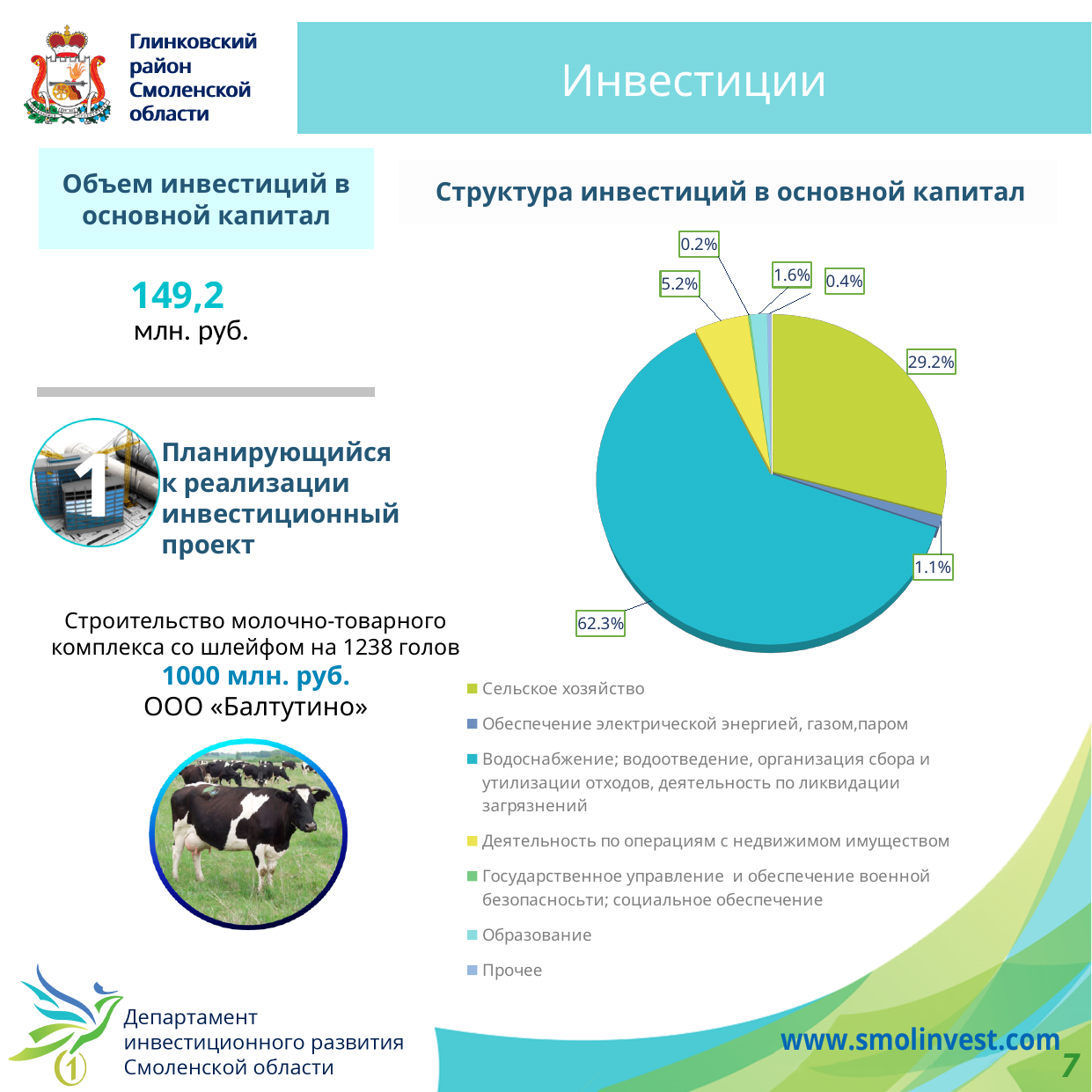
In the pie chart, what share is shown for "Водоснабжение; водоотведение, организация сбора и утилизации отходов, деятельность по ликвидации загрязнений"? 62.3% In the pie chart, what share is shown for "Обеспечение электрической энергией, газом,паром"? 1.1% How many categories does the legend of the pie chart list? 7 In the pie chart, what share is shown for "Деятельность по операциям с недвижимым имуществом"? 5.2% In the pie chart, what is the difference in percentage points between the shares for "Водоснабжение..." (62.3%) and "Сельское хозяйство" (29.2%)? 33.1 In the pie chart, what share is shown for "Прочее"? 0.4% Which category has the smallest slice in the pie chart? Государственное управление и обеспечение военной безопасности; социальное обеспечение In the pie chart, what share is shown for "Образование"? 1.6% In the pie chart, what share is shown for "Сельское хозяйство"? 29.2% Which category has the largest slice in the pie chart? Водоснабжение; водоотведение, организация сбора и утилизации отходов, деятельность по ликвидации загрязнений What kind of chart is shown under the title "Структура инвестиций в основной капитал"? pie chart In the pie chart, which is larger: the share for "Образование" or the share for "Обеспечение электрической энергией, газом,паром"? Образование